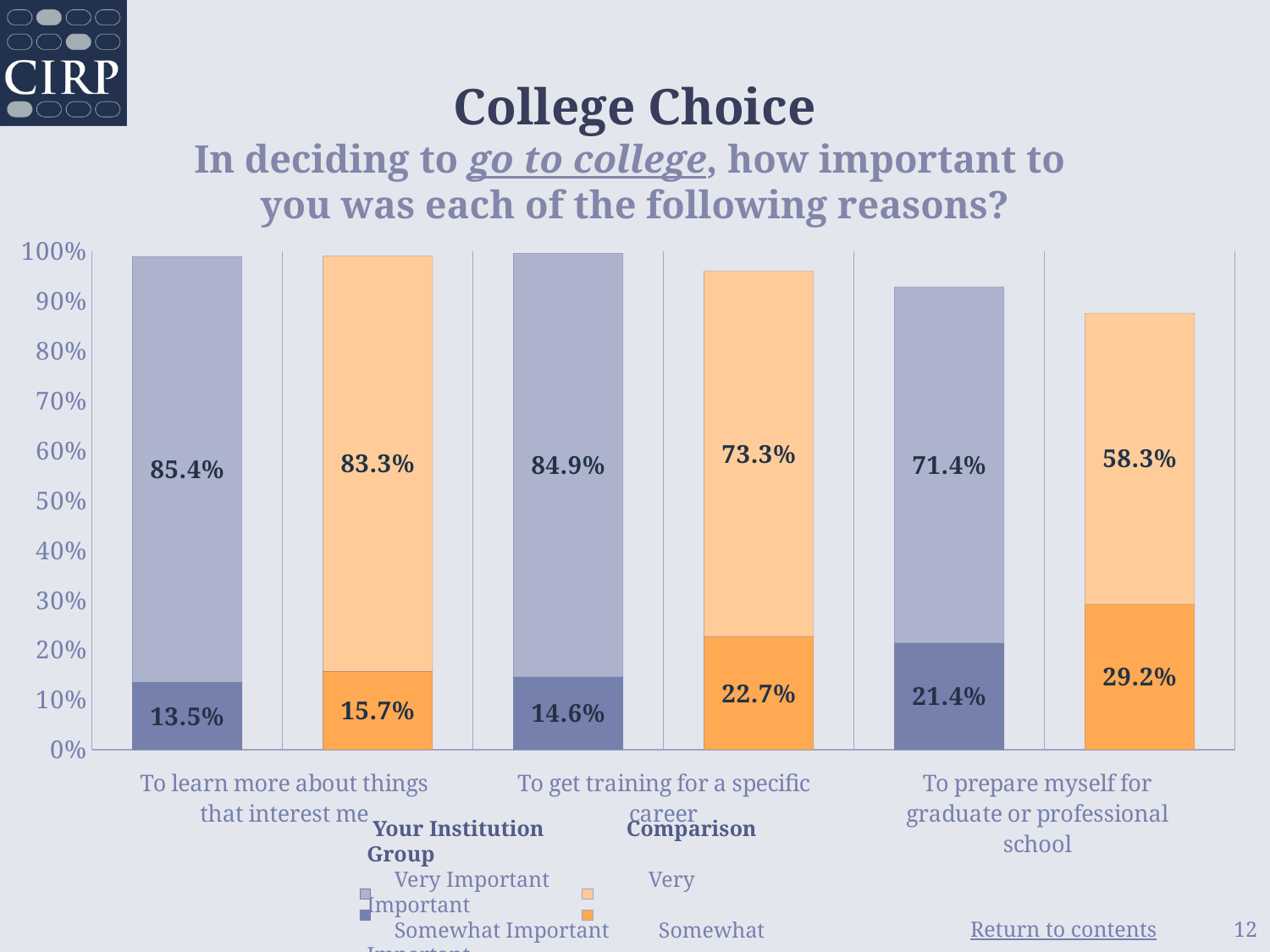
For "To prepare myself for graduate or professional school", which group has the larger Somewhat Important percentage, Your Institution or the Comparison Group? Comparison Group What percentage of Your Institution students rated "To learn more about things that interest me" as Very Important? 85.4% How many reasons (categories) are shown on the x axis of the chart? 3 What percentage of the Comparison Group rated "To get training for a specific career" as Very Important? 73.3% What is the combined Very Important and Somewhat Important percentage for the Comparison Group on "To prepare myself for graduate or professional school"? 87.5% Which reason has the lowest Very Important percentage for the Comparison Group? To prepare myself for graduate or professional school Which reason has the highest Very Important percentage for Your Institution? To learn more about things that interest me What percentage of the Comparison Group rated "To prepare myself for graduate or professional school" as Somewhat Important? 29.2% What kind of chart is shown on the slide? Stacked bar chart What is the difference between Your Institution and the Comparison Group Very Important percentages for "To get training for a specific career"? 11.6% How many series does the legend list? 4 What is the combined Very Important and Somewhat Important percentage for Your Institution on "To get training for a specific career"? 99.5%